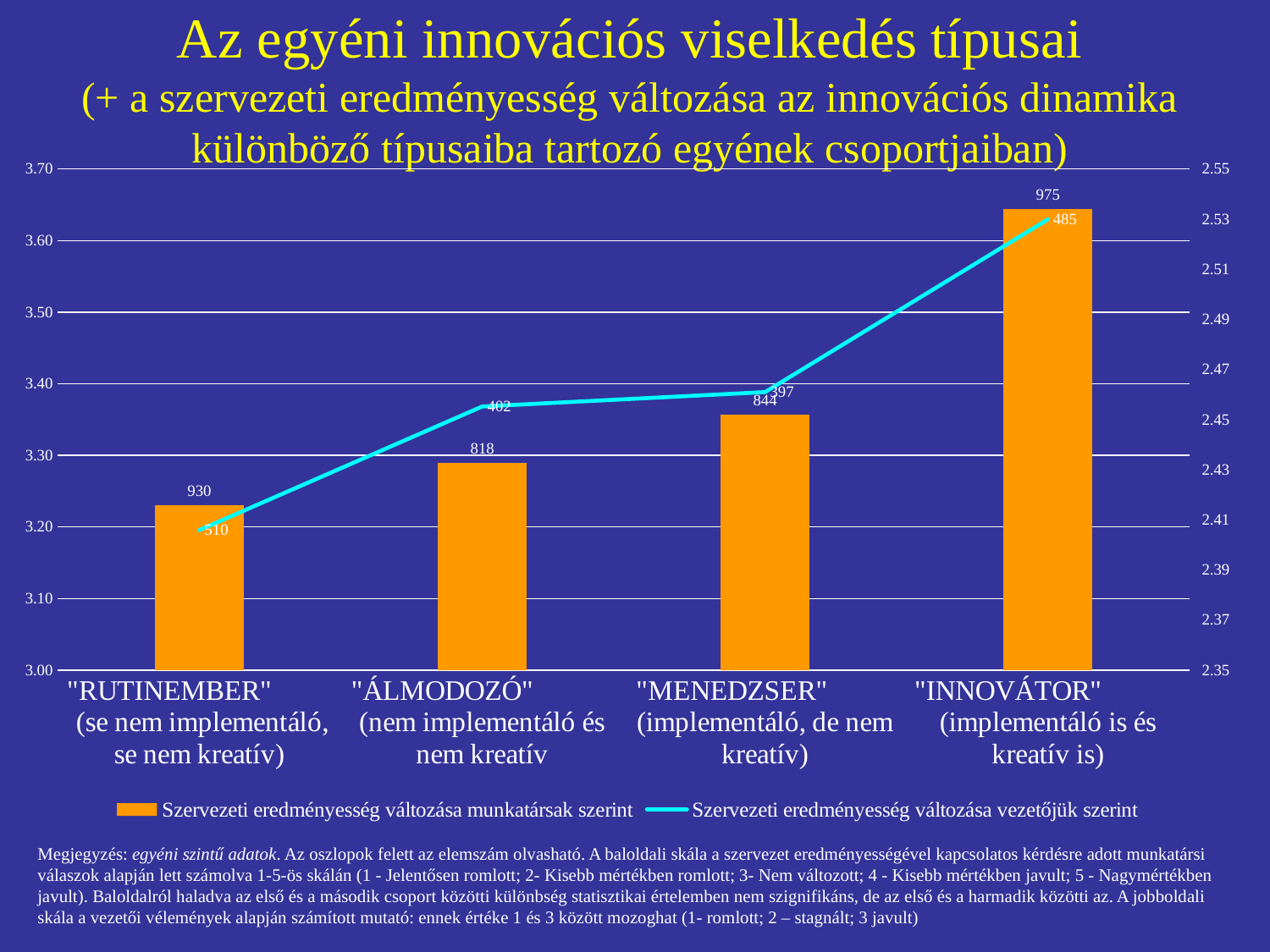
What number (element count) is printed above the orange bar for "ÁLMODOZÓ"? 818 Which category has the tallest orange bar (Szervezeti eredményesség változása munkatársak szerint)? "INNOVÁTOR" How many series does the legend list? 2 Which orange bar is taller: "MENEDZSER" or "INNOVÁTOR"? "INNOVÁTOR" How many categories (types of individual innovation behaviour) are shown on the x axis? 4 At which category does the cyan line (Szervezeti eredményesség változása vezetőjük szerint) reach its highest point? "INNOVÁTOR" Is the orange bar for "INNOVÁTOR" greater or less than 3.60 on the left axis? greater What type of chart is shown on the slide? A combined bar and line chart Which category has the shortest orange bar? "RUTINEMBER" Is the orange bar for "RUTINEMBER" greater or less than 3.30 on the left axis? less Is the cyan line value for "INNOVÁTOR" greater or less than 2.51 on the right axis? greater